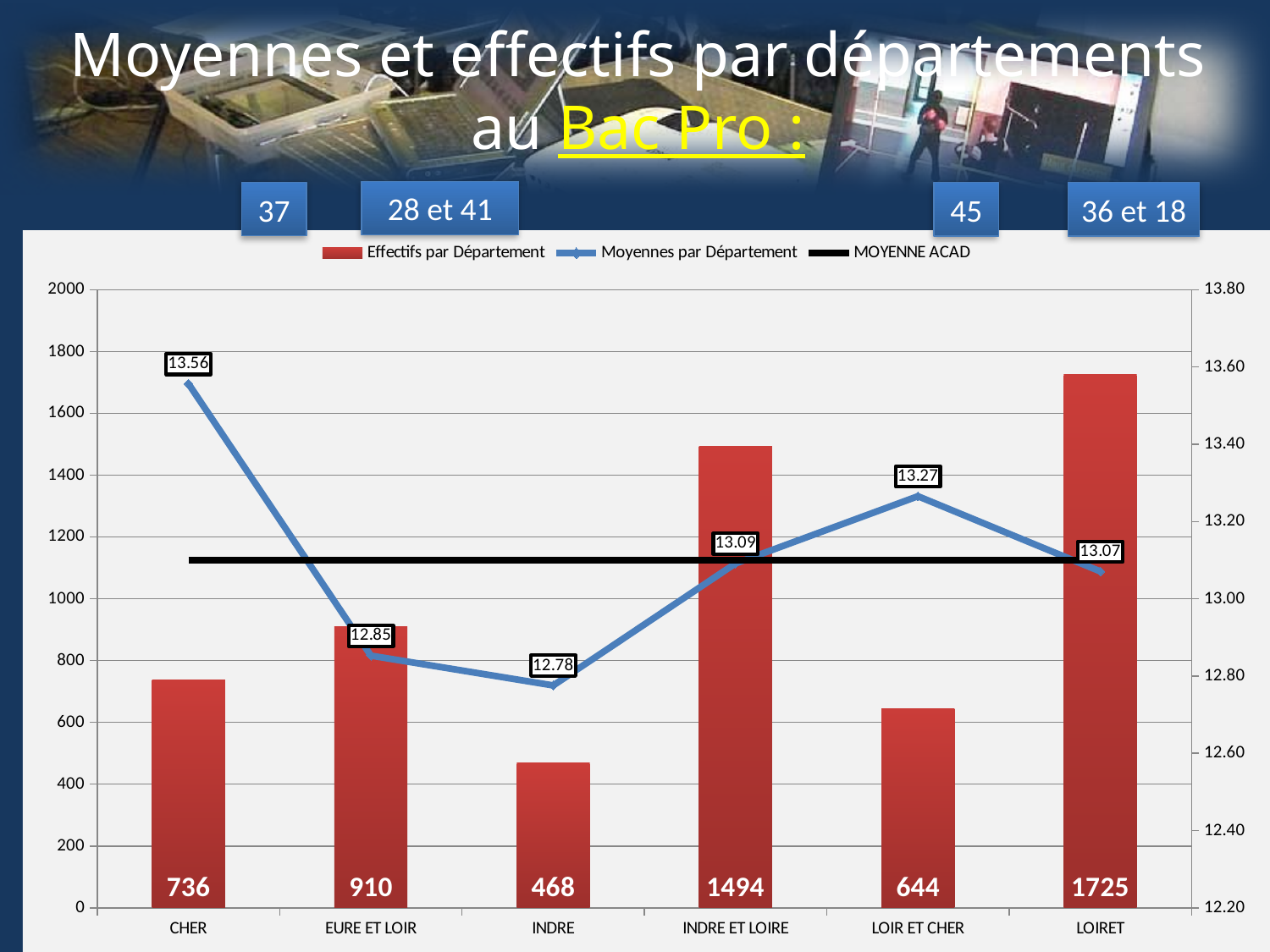
Is the Effectifs par Département value for LOIR ET CHER greater or less than 800? less What is the difference between the Moyennes par Département values for CHER and INDRE? 0.78 What is the value of Effectifs par Département for INDRE ET LOIRE? 1494 Which department has the lowest Moyennes par Département? INDRE How many series does the legend list? 3 What is the difference in Effectifs par Département between LOIRET and INDRE? 1257 Which department has the highest Effectifs par Département? LOIRET What is the Moyennes par Département value for CHER? 13.56 Which series is drawn as a black horizontal line? MOYENNE ACAD What is the Moyennes par Département value for LOIR ET CHER? 13.27 Which has a larger Effectifs par Département, CHER or EURE ET LOIR? EURE ET LOIR How many departments are shown on the x axis? 6